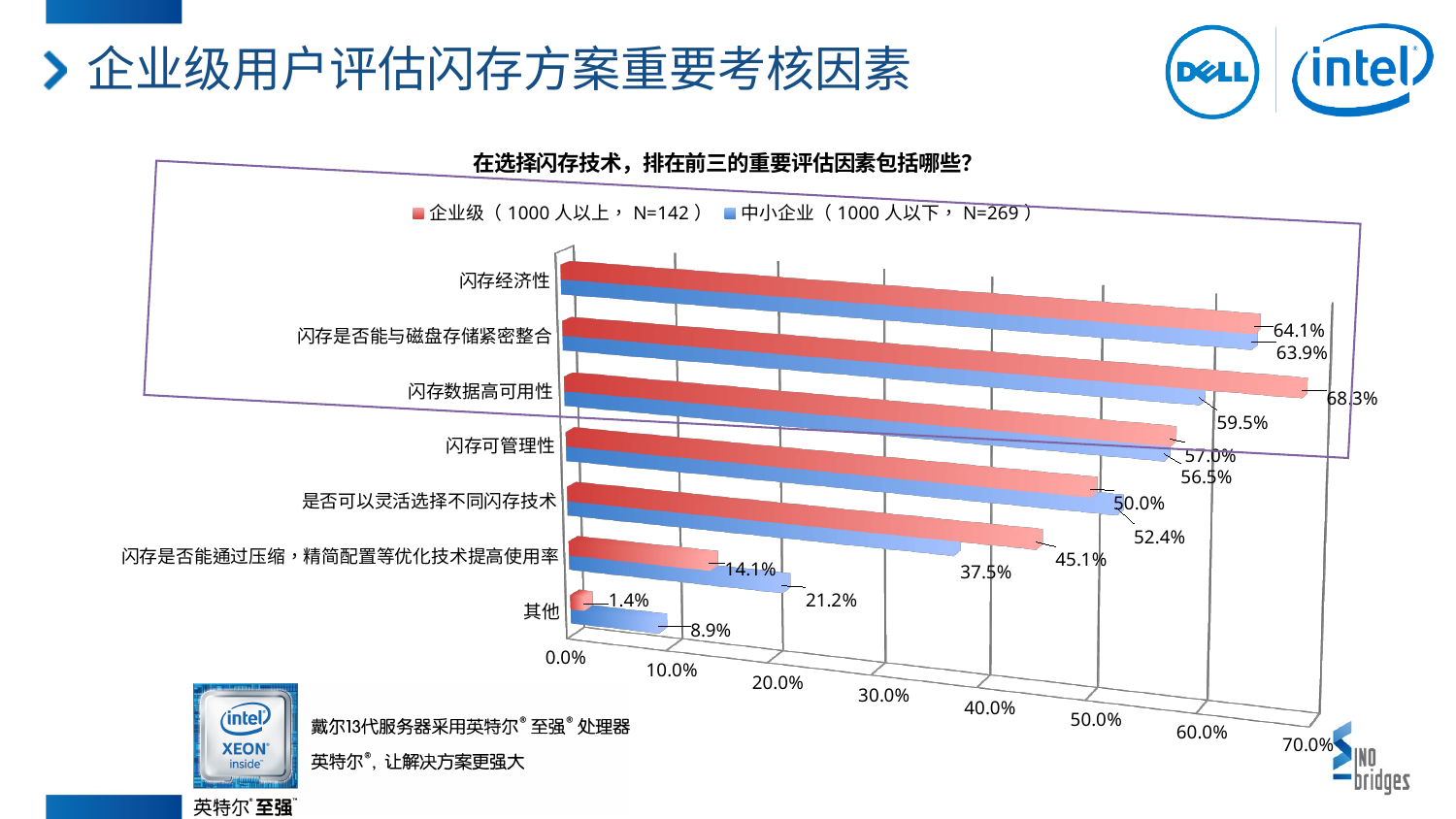
Which category has the highest value for the 企业级（1000人以上）series? 闪存是否能与磁盘存储紧密整合 How many categories (evaluation factors) are plotted in the chart? 7 What kind of chart is shown on the slide? Bar chart For 闪存是否能与磁盘存储紧密整合, what is the difference between the 企业级 value and the 中小企业 value? 8.8 percentage points What is the value for 中小企业（1000人以下）for 闪存可管理性? 52.4% For 闪存是否能通过压缩，精简配置等优化技术提高使用率, which series has the larger value, 企业级 or 中小企业? 中小企业 What is the value for 中小企业（1000人以下）for 其他? 8.9% How many series does the legend list? 2 What is the value for 企业级（1000人以上）for 是否可以灵活选择不同闪存技术? 45.1% What is the value for 企业级（1000人以上）for 闪存经济性? 64.1% According to the legend, what is the sample size (N) for the 企业级 series? N=142 Which category has the lowest value for the 中小企业（1000人以下）series? 其他